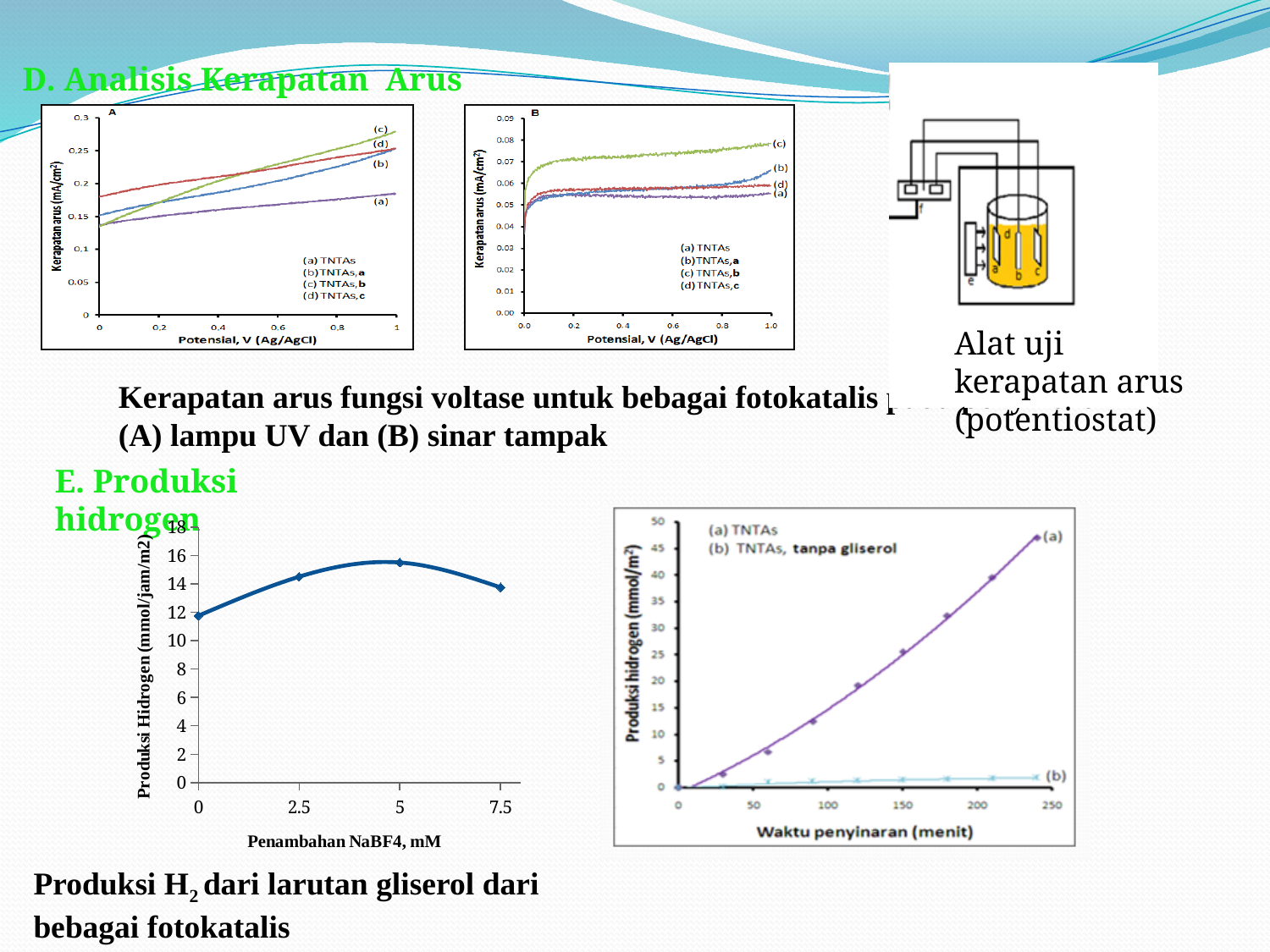
In the bottom-left chart (Produksi Hidrogen vs Penambahan NaBF4), is the value at 0 mM greater or less than 14? less In chart A (top left, Kerapatan arus vs Potensial), what is the label of the x axis? Potensial, V (Ag/AgCl) In the bottom-left chart (Produksi Hidrogen vs Penambahan NaBF4), at which NaBF4 addition is hydrogen production highest? 5 mM In chart A (top left, Kerapatan arus vs Potensial), which curve is highest at a potential of 1 V? (c) TNTAs,b In the bottom-left chart (Produksi Hidrogen vs Penambahan NaBF4), how does hydrogen production change as NaBF4 addition increases from 0 to 7.5 mM? rises then falls In the bottom-left chart (Produksi Hidrogen vs Penambahan NaBF4), is the value at 5 mM greater or less than 14? greater In the bottom-left chart (Produksi Hidrogen vs Penambahan NaBF4), at which NaBF4 addition is hydrogen production lowest? 0 mM In the bottom-right chart (Produksi hidrogen vs Waktu penyinaran), is the value of series (a) TNTAs at 240 minutes greater or less than 45? greater In the bottom-right chart (Produksi hidrogen vs Waktu penyinaran), which series is higher at 240 minutes, (a) TNTAs or (b) TNTAs tanpa gliserol? (a) TNTAs What kind of chart is the bottom-left chart of Produksi Hidrogen versus Penambahan NaBF4? line chart In the bottom-right chart (Produksi hidrogen vs Waktu penyinaran), how many series does the legend list? 2 In the bottom-left chart (Produksi Hidrogen vs Penambahan NaBF4), how many data points are plotted? 4